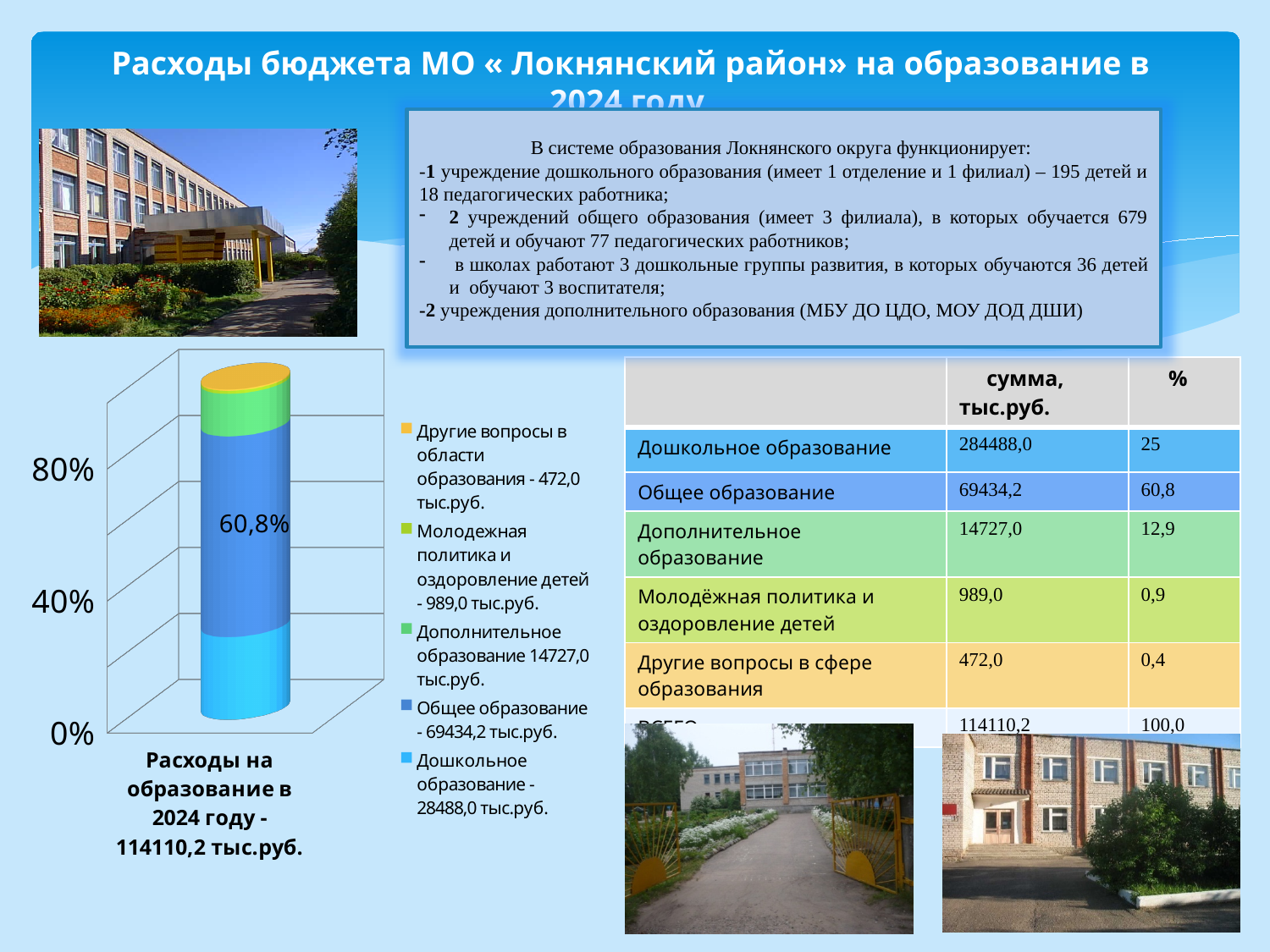
Which segment is larger in the bar: Общее образование or Дошкольное образование? Общее образование What total amount is stated in the chart's category label for Расходы на образование в 2024 году? 114110,2 тыс.руб. What percentage is printed on the bar segment for Общее образование? 60,8% According to the chart legend, what amount is given for Молодежная политика и оздоровление детей? 989,0 тыс.руб. Which legend entry is listed first (at the top) in the chart legend? Другие вопросы в области образования - 472,0 тыс.руб. What kind of chart is shown on the slide? Stacked bar chart How many categories (bars) does the chart show? 1 Which segment of the stacked bar is the largest? Общее образование How many series does the chart legend list? 5 Is the share of the bar for Дошкольное образование greater or less than 40%? less According to the chart legend, what amount is given for Дополнительное образование? 14727,0 тыс.руб. What colour is the segment for Общее образование in the chart? Blue